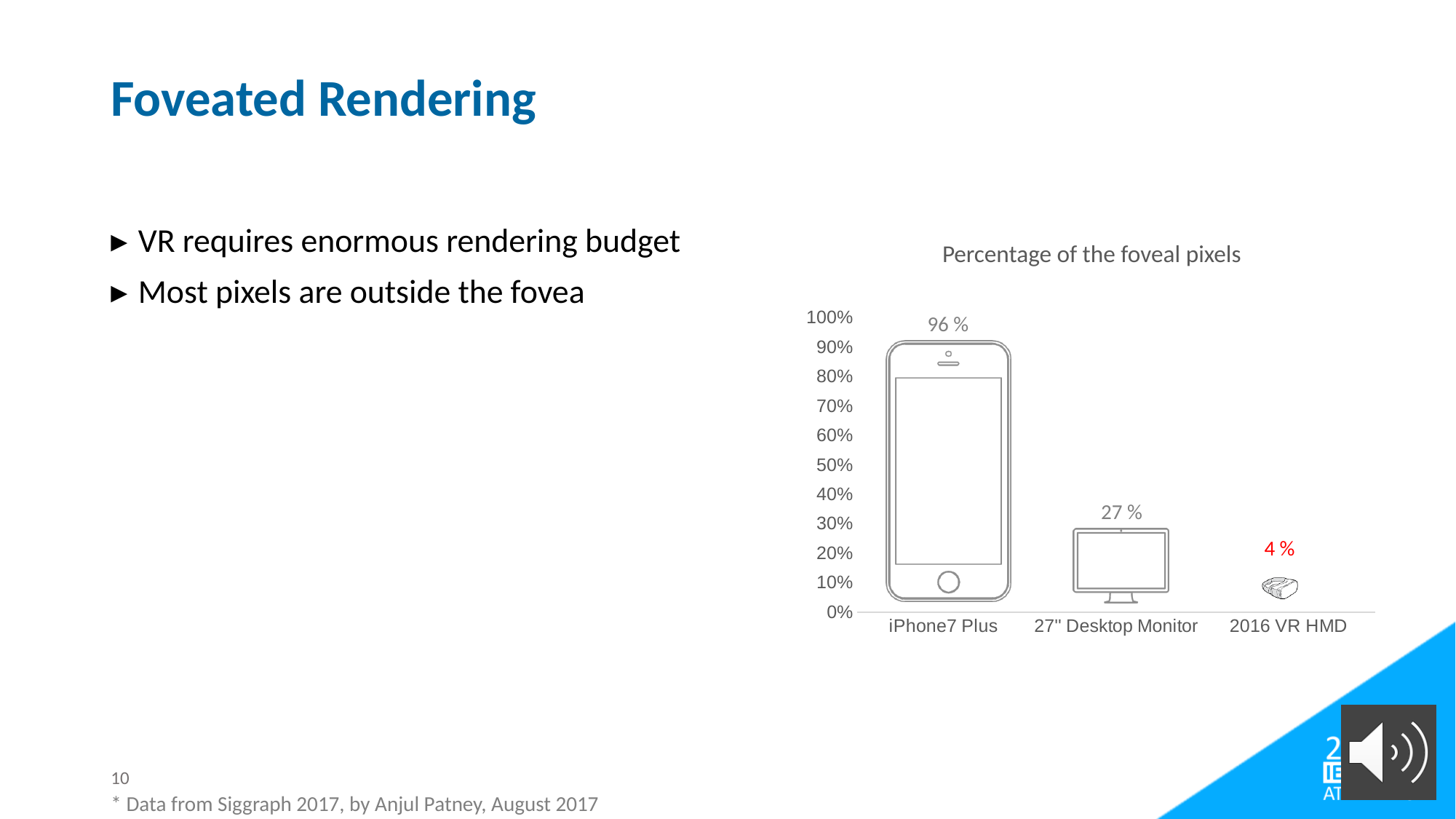
What is the difference between the values for 27'' Desktop Monitor and 2016 VR HMD? 23 % What is the value for 27'' Desktop Monitor? 27 % What is the title of the chart? Percentage of the foveal pixels Do the values rise or fall from left to right along the x axis? fall What is the value for iPhone7 Plus? 96 % Which category has the highest percentage of foveal pixels? iPhone7 Plus Is the value for 27'' Desktop Monitor greater or less than 50%? less Which category has the lowest percentage of foveal pixels? 2016 VR HMD Which is larger, the value for 27'' Desktop Monitor or the value for 2016 VR HMD? 27'' Desktop Monitor How many categories are shown on the x axis of the chart? 3 What is the value for 2016 VR HMD? 4 % What is the difference between the values for iPhone7 Plus and 27'' Desktop Monitor? 69 %